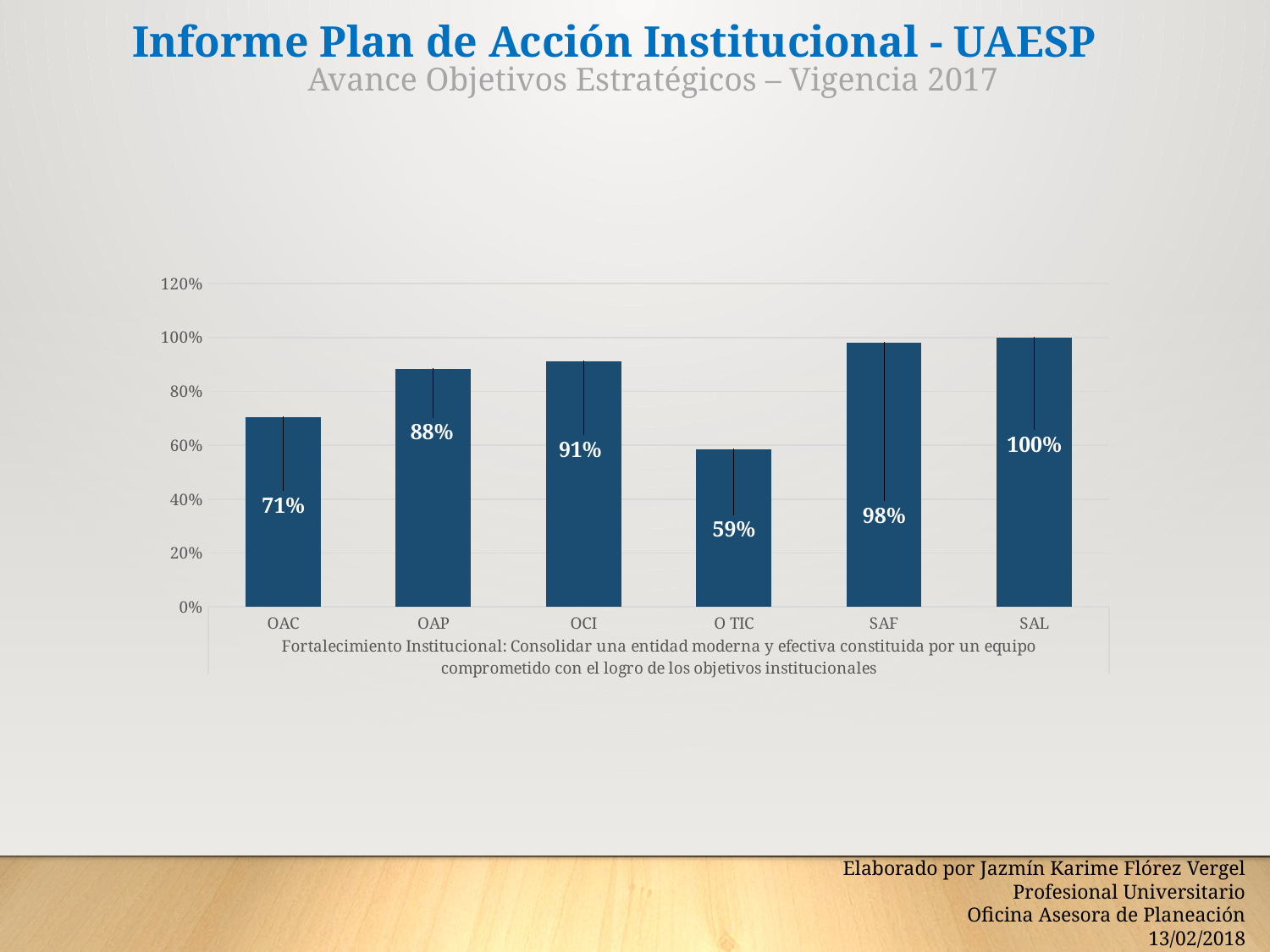
What is the highest value shown on the vertical axis? 120% What is the difference between the values for SAL and O TIC? 41% What kind of chart is shown on the slide? bar chart What is the value for OAC? 71% Which category has the highest value? SAL What is the difference between the values for OCI and OAP? 3% How many categories are shown on the x axis? 6 What is the value for O TIC? 59% Which category has the lowest value? O TIC What is the value for SAF? 98% Which is larger, the value for OAP or the value for OAC? OAP Is the value for OCI greater or less than 80%? greater